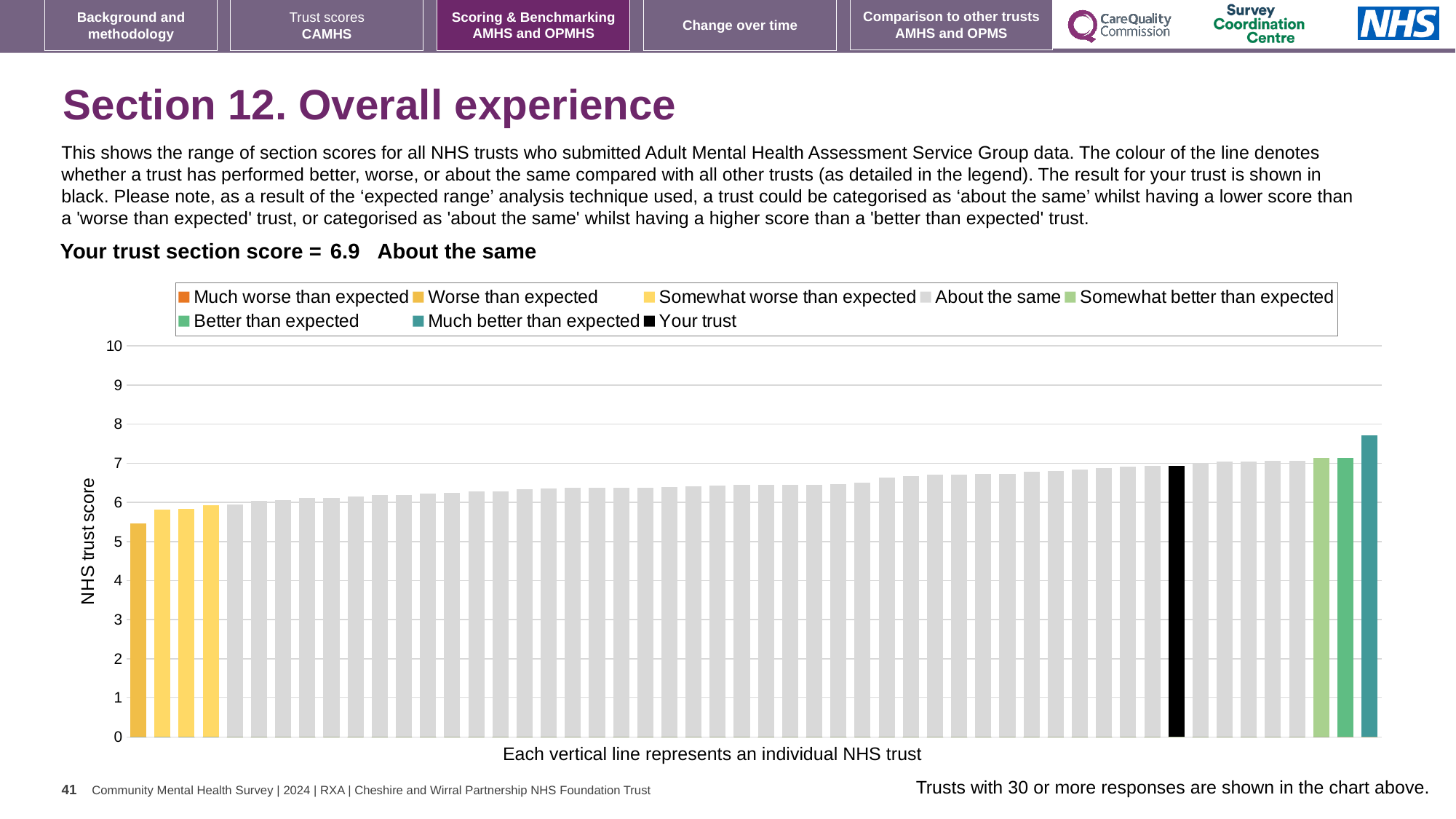
Do the bar values rise or fall from left to right along the x axis? rise Is the value of the lowest bar in the chart greater or less than 6? less Which category is your trust placed in for this section? About the same What is the label on the y axis of the chart? NHS trust score Which is larger: the value for your trust (black bar) or the value of the leftmost bar? your trust Is the value of the highest bar in the chart greater or less than 8? less What kind of chart is shown on the slide? bar chart Is the value of the highest bar in the chart greater or less than 7? greater How many entries does the chart legend list? 8 What is the section score for your trust shown on the slide? 6.9 Which legend category does the highest bar in the chart belong to? Much better than expected